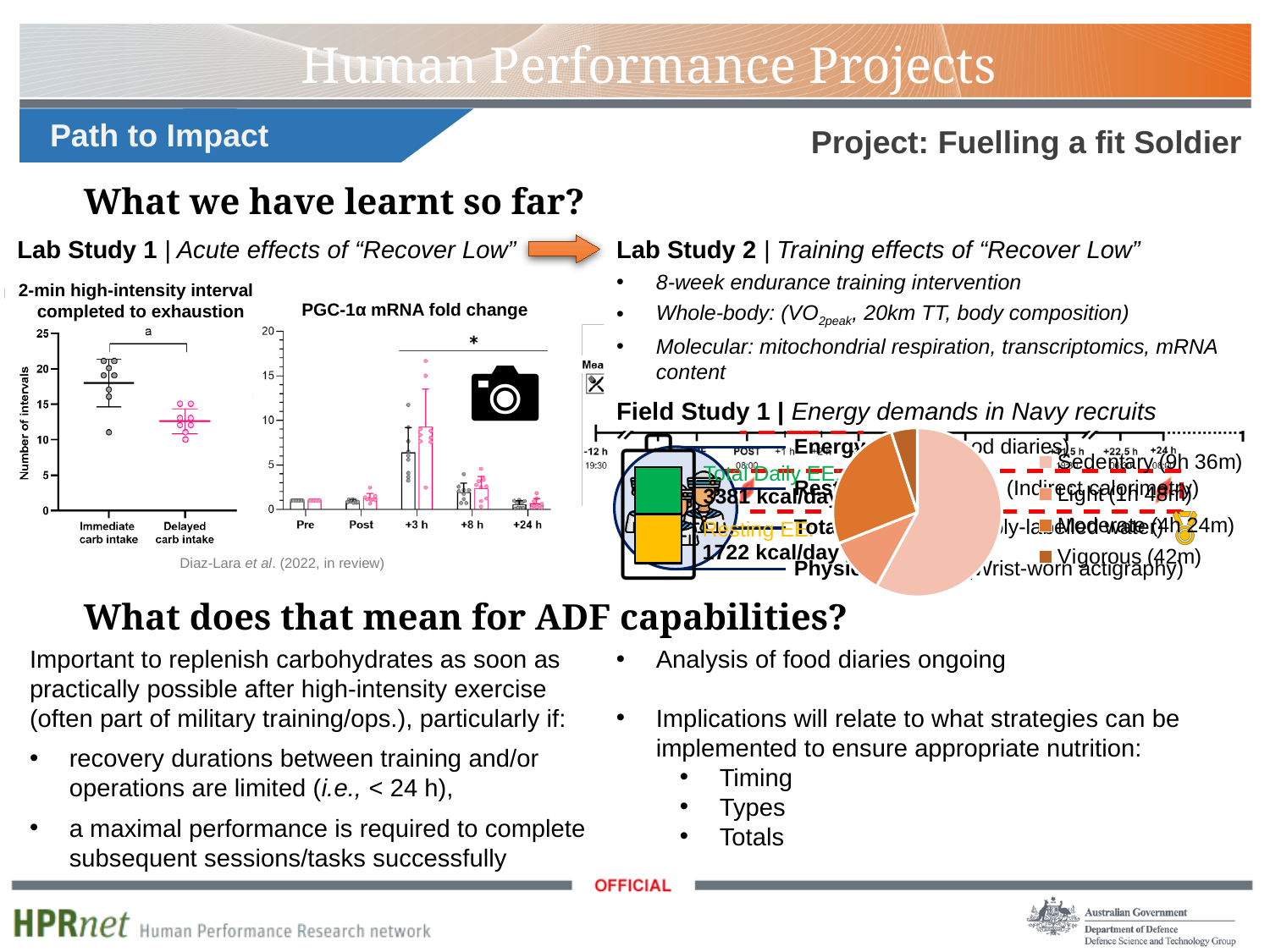
How many time points are shown on the x axis of the 'PGC-1α mRNA fold change' chart? 5 What is the y-axis label of the '2-min high-intensity interval completed to exhaustion' chart? Number of intervals In the 'PGC-1α mRNA fold change' chart, is the fold change at Pre greater or less than 5? less In the 'PGC-1α mRNA fold change' chart, is the fold change for the pink bar at +3 h greater or less than 5? greater In the '2-min high-intensity interval completed to exhaustion' chart, which group has the higher number of intervals, Immediate carb intake or Delayed carb intake? Immediate carb intake In the 'PGC-1α mRNA fold change' chart, at which time point is the fold change highest? +3 h In the '2-min high-intensity interval completed to exhaustion' chart, is the mean number of intervals for Delayed carb intake greater or less than 15? less How many categories does the legend of the pie chart in the Field Study 1 section list? 4 How many groups are compared in the '2-min high-intensity interval completed to exhaustion' chart? 2 In the pie chart in the Field Study 1 section, which activity category has the largest slice? Sedentary (9h 36m) What kind of chart is the 'PGC-1α mRNA fold change' chart? bar chart